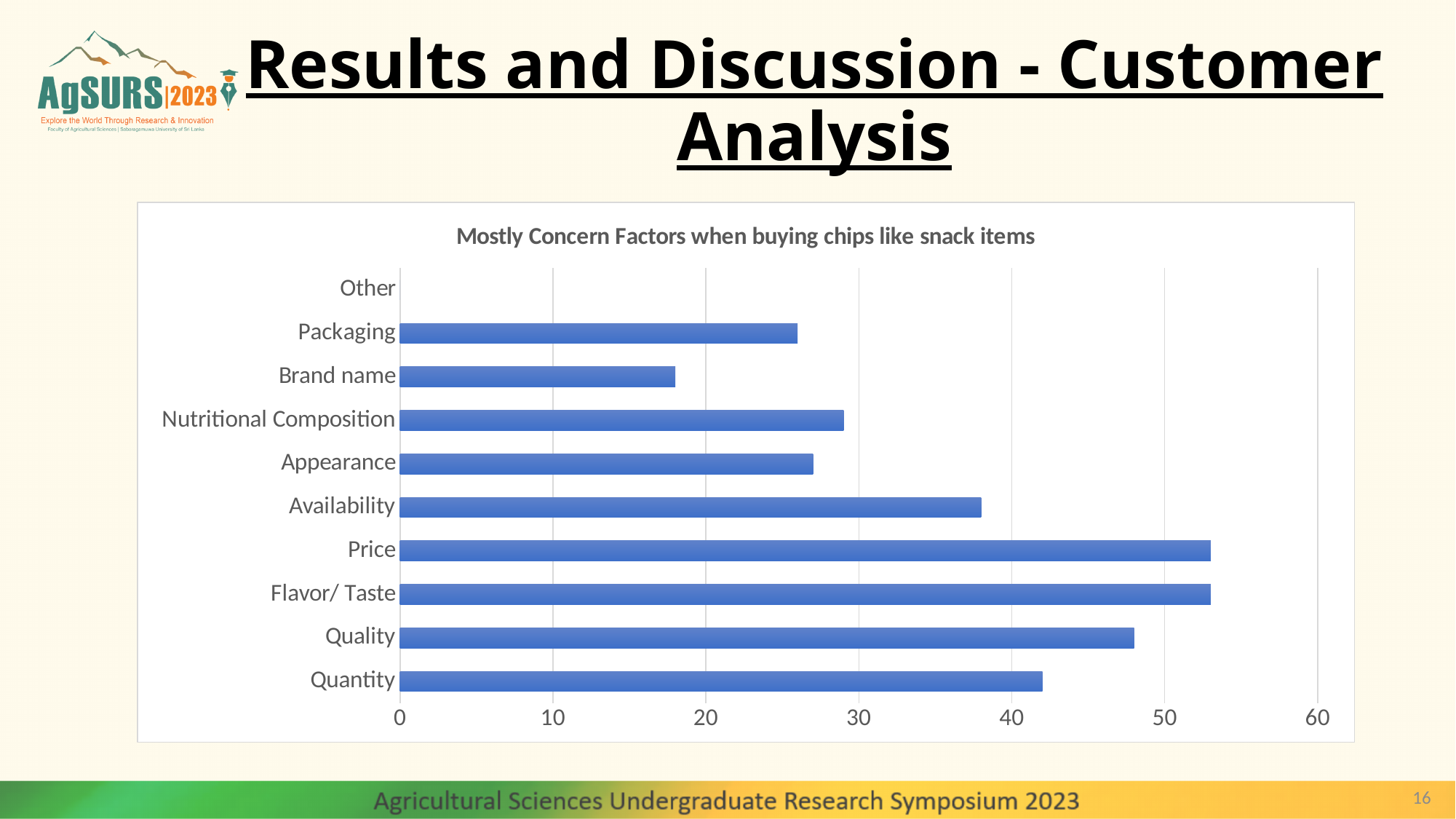
What kind of chart is shown on the slide? bar chart Which has a larger value, Quality or Quantity? Quality What is the highest value shown on the horizontal axis? 60 Which category has the shortest visible bar? Brand name Which has a larger value, Brand name or Nutritional Composition? Nutritional Composition Is the value for Brand name greater or less than 20? less Is the value for Availability greater or less than 40? less Is the value for Quantity greater or less than 40? greater What is the title of the chart? Mostly Concern Factors when buying chips like snack items How many categories are listed on the chart's vertical axis? 10